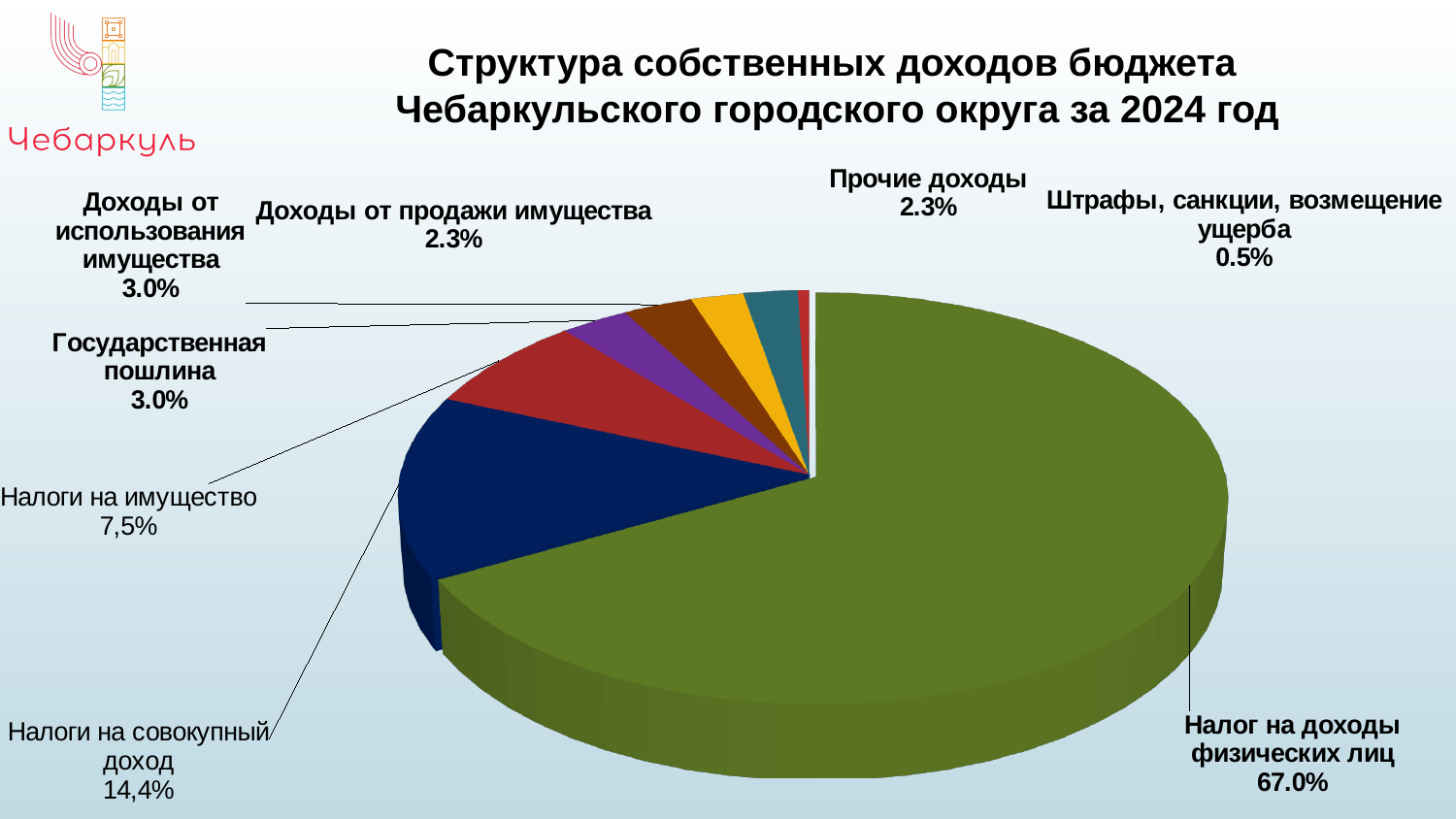
What is the value shown for "Налоги на имущество"? 7,5% What is the value shown for "Государственная пошлина"? 3.0% What share of the pie does "Налог на доходы физических лиц" have? 67.0% What kind of chart is shown on the slide? Pie chart Which is larger: "Налоги на совокупный доход" or "Налоги на имущество"? Налоги на совокупный доход Which category has the smallest slice of the pie? Штрафы, санкции, возмещение ущерба What is the value shown for "Штрафы, санкции, возмещение ущерба"? 0.5% What is the title of the chart? Структура собственных доходов бюджета Чебаркульского городского округа за 2024 год Which category has the largest slice of the pie? Налог на доходы физических лиц What is the value shown for "Налоги на совокупный доход"? 14,4% How many categories (slices) does the pie chart have? 8 What is the difference in percentage points between "Налог на доходы физических лиц" (67.0%) and "Налоги на совокупный доход" (14,4%)? 52.6